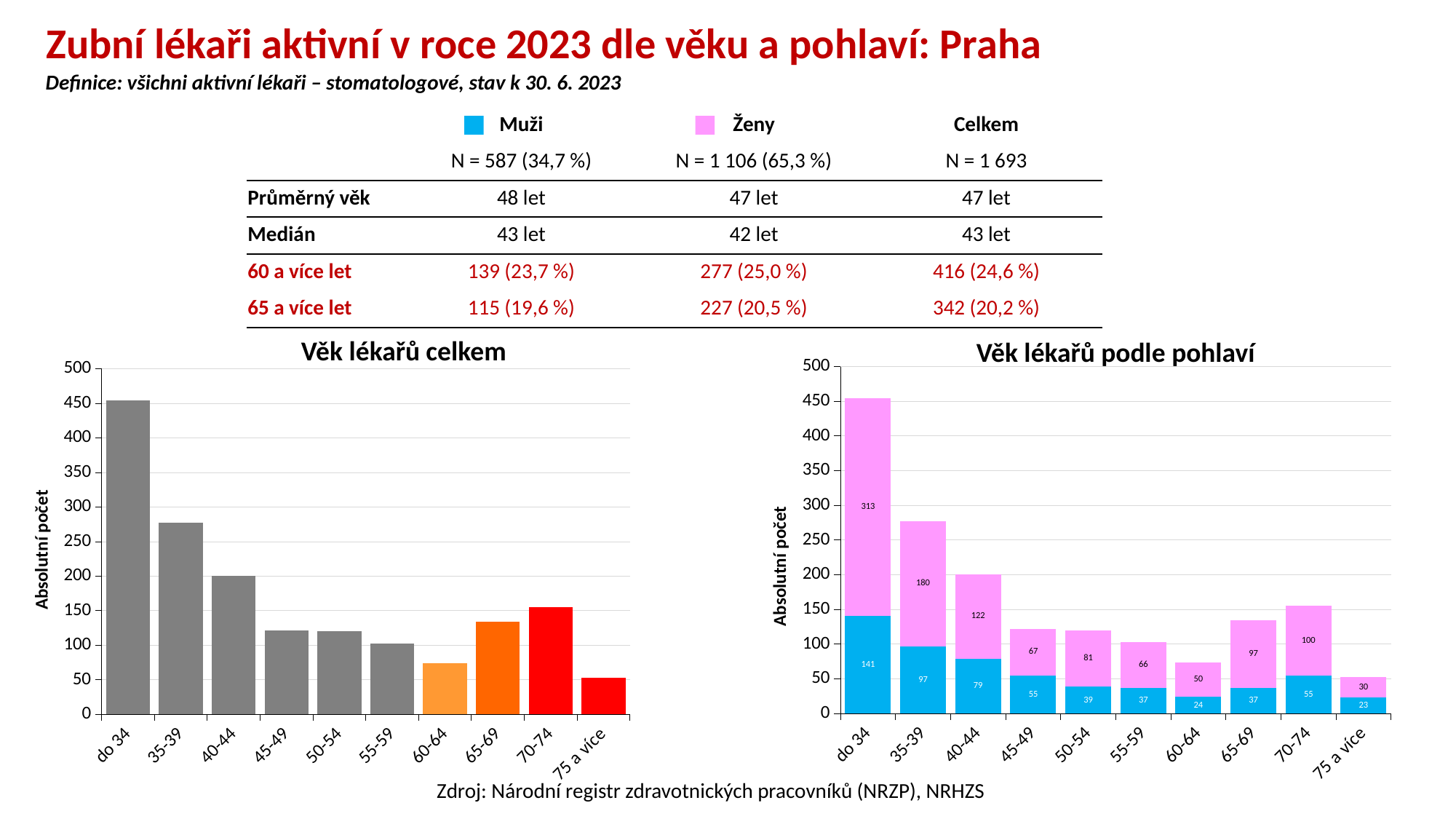
In the chart 'Věk lékařů celkem', is the value for '65-69' greater or less than 150? less What type of chart is 'Věk lékařů podle pohlaví'? Stacked bar chart In the chart 'Věk lékařů podle pohlaví', what is the total of the stacked bar for '35-39'? 277 How many age groups are shown on the x axis of the chart 'Věk lékařů celkem'? 10 In the chart 'Věk lékařů podle pohlaví', what is the value for Muži in the '70-74' age group? 55 In the chart 'Věk lékařů podle pohlaví', what is the value for Muži in the '60-64' age group? 24 In the chart 'Věk lékařů podle pohlaví', which age group has the highest value for Muži? do 34 In the chart 'Věk lékařů podle pohlaví', what is the value for Ženy in the 'do 34' age group? 313 In the chart 'Věk lékařů podle pohlaví', what is the difference between Ženy and Muži in the '40-44' age group? 43 In the chart 'Věk lékařů podle pohlaví', is the value for Ženy larger in '50-54' or in '55-59'? 50-54 In the chart 'Věk lékařů celkem', is the value for 'do 34' greater or less than 400? greater In the chart 'Věk lékařů podle pohlaví', which age group has the lowest value for Ženy? 75 a více